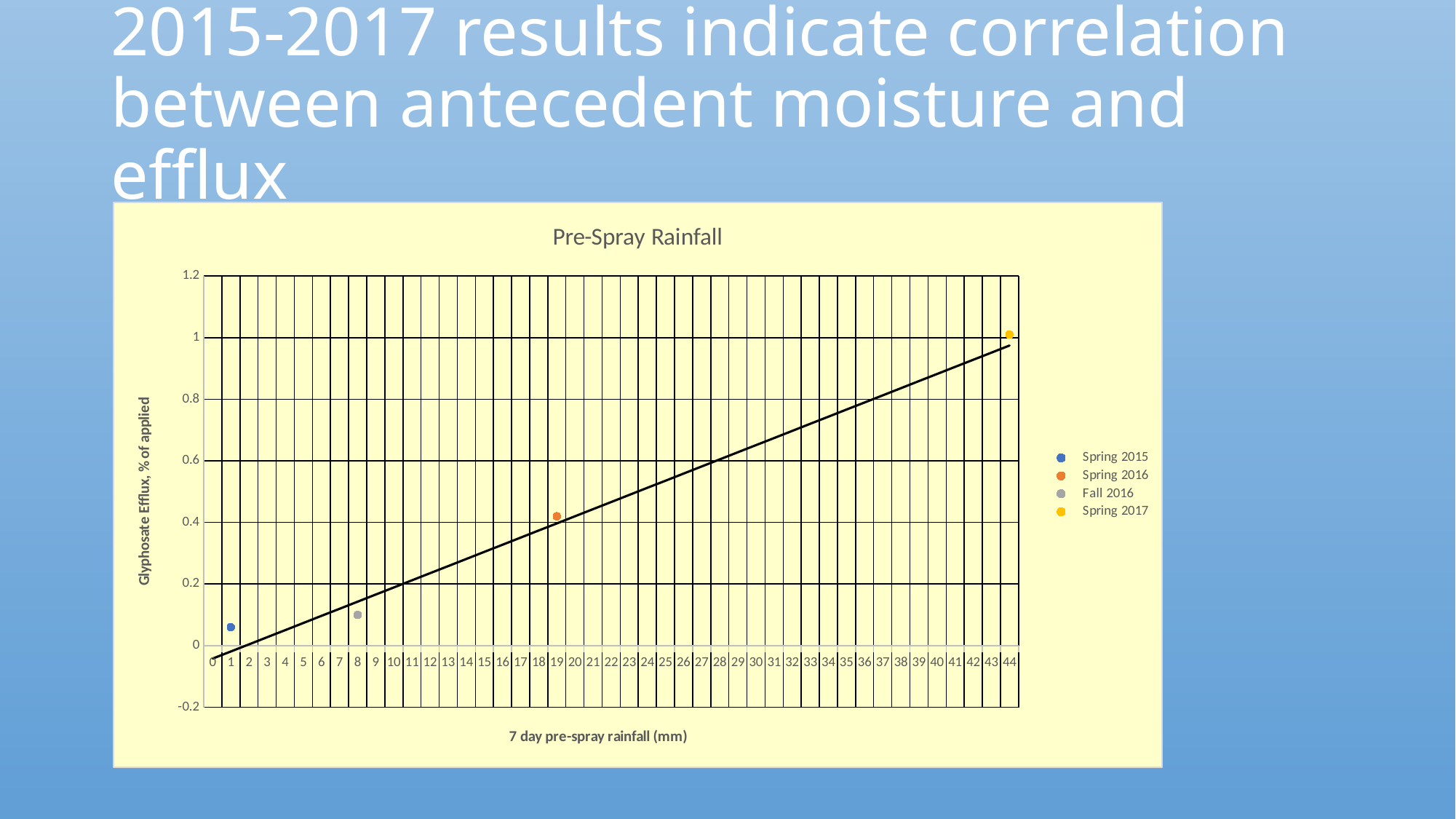
Is the glyphosate efflux for Fall 2016 greater or less than 0.2? less What is the title of the chart? Pre-Spray Rainfall Which series has the highest glyphosate efflux? Spring 2017 Which series has the lowest glyphosate efflux? Spring 2015 Does glyphosate efflux rise or fall as 7 day pre-spray rainfall increases? rises What is the label of the x axis? 7 day pre-spray rainfall (mm) Is the glyphosate efflux for Spring 2016 greater or less than 0.2? greater What is the 7 day pre-spray rainfall (mm) for the Spring 2017 point? 44 What kind of chart is shown on the slide? Scatter chart Which has a higher glyphosate efflux, Spring 2016 or Fall 2016? Spring 2016 How many series does the legend list? 4 Is the glyphosate efflux for Spring 2017 greater or less than 0.8? greater